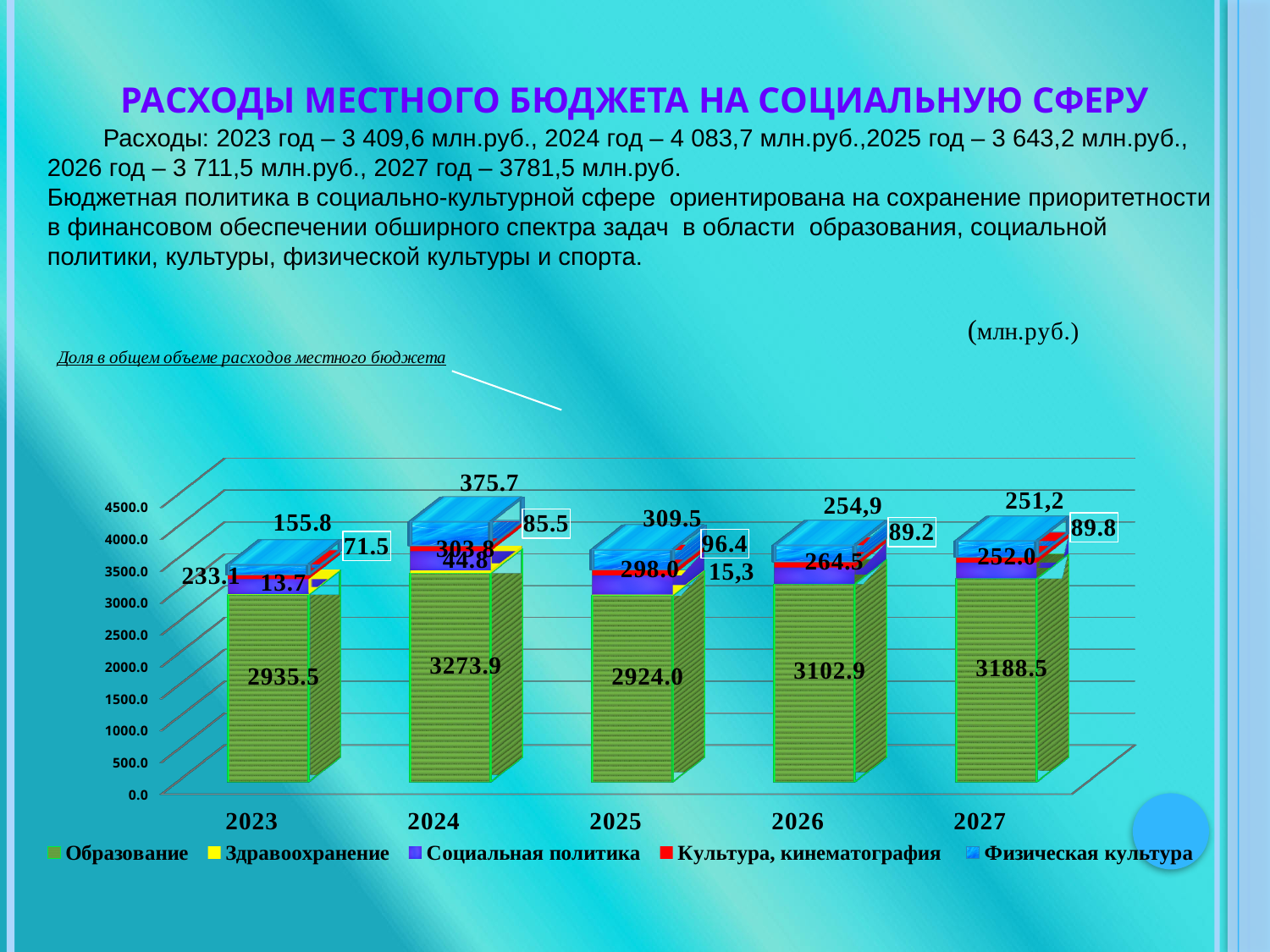
Which year has the lowest value for Образование? 2025 What is the value for Образование in 2024? 3273.9 Is the Образование value for 2023 greater or less than 2500.0? greater What is the value for Образование in 2027? 3188.5 How many series does the chart legend list? 5 Which series is shown in green in the chart legend? Образование Which year has the highest value for Образование? 2024 How many years are shown on the x axis of the chart? 5 What is the difference between the Образование values for 2024 and 2023? 338.4 What kind of chart is shown on the slide? Stacked bar chart Which is larger, the Образование value for 2026 or for 2027? 2027 What is the value for Образование in 2025? 2924.0